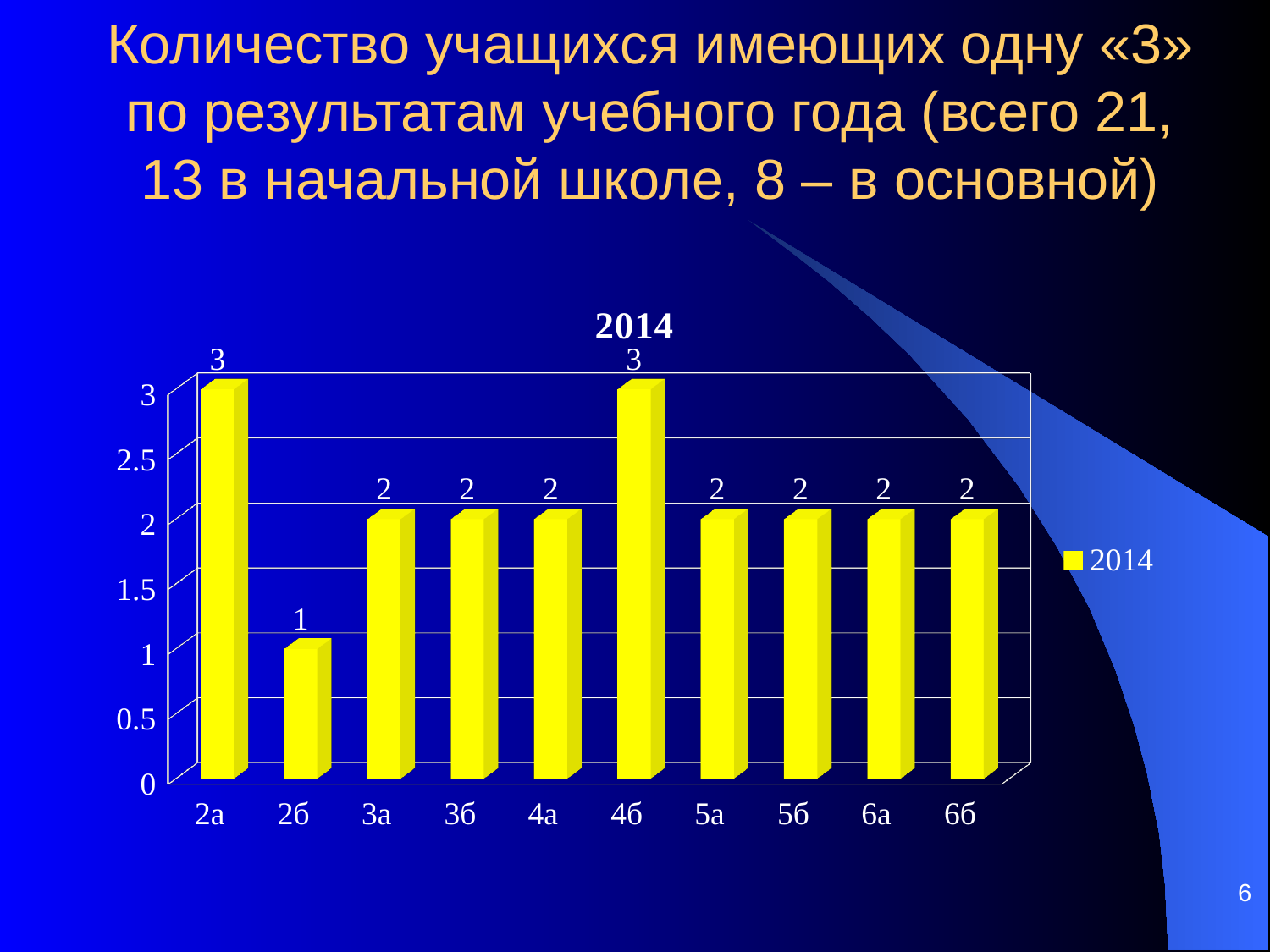
Which category has the lowest value in the chart? 2б What is the value for 5а in the chart? 2 What is the difference between the values for 4б and 3а? 1 Which is larger, the value for 4б or the value for 5б? 4б How many series does the legend list? 1 What is the difference between the values for 2а and 2б? 2 What is the title of the chart? 2014 What is the value for 4б in the chart? 3 What is the value for 2б in the chart? 1 How many categories are shown on the x axis of the chart? 10 What is the value for 2а in the chart? 3 What type of chart is shown on the slide? bar chart